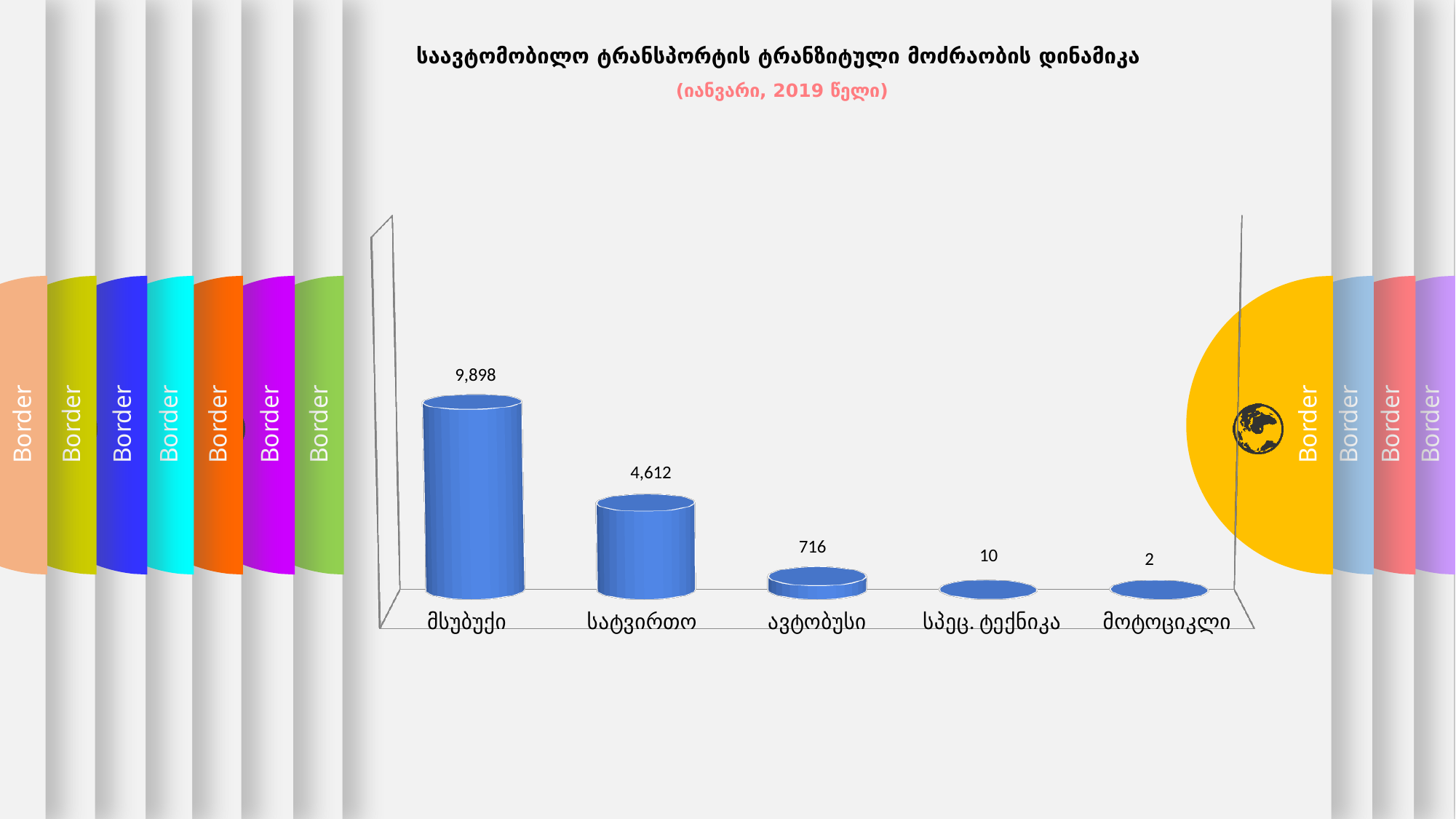
What is the value for მოტოციკლი? 2 Do the values rise or fall from left to right along the x axis? fall What is the value for სპეც. ტექნიკა? 10 Which category has the highest value? მსუბუქი What is the value for სატვირთო? 4,612 What is the value for ავტობუსი? 716 Which category has the lowest value? მოტოციკლი How many categories are shown on the chart? 5 Which is larger, the value for ავტობუსი or the value for სპეც. ტექნიკა? ავტობუსი What is the value for მსუბუქი? 9,898 What kind of chart is shown on the slide? bar chart What is the difference between the values for მსუბუქი and სატვირთო? 5,286